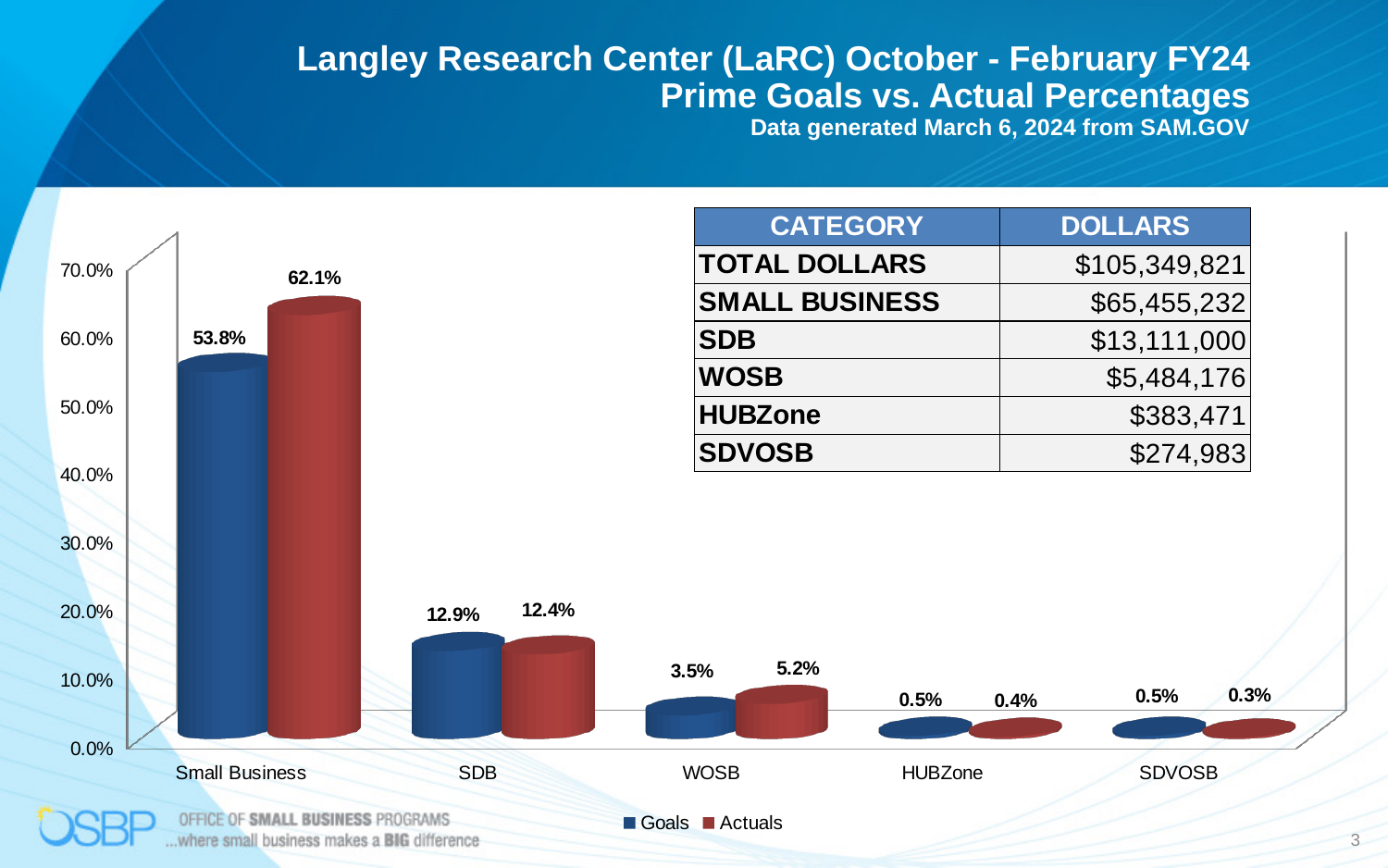
What is the Actuals value for Small Business? 62.1% Is the Goals value for Small Business greater or less than 50.0%? greater What is the difference between the Actuals and Goals values for Small Business? 8.3% How many categories are shown on the x axis of the chart? 5 What kind of chart is shown on the slide? Bar chart For SDB, which is larger, the Goals value or the Actuals value? Goals Which category has the lowest Actuals value? SDVOSB Which category has the highest Actuals value? Small Business What is the Actuals value for WOSB? 5.2% What is the Goals value for SDB? 12.9% What is the Goals value for HUBZone? 0.5% How many series does the chart legend list? 2